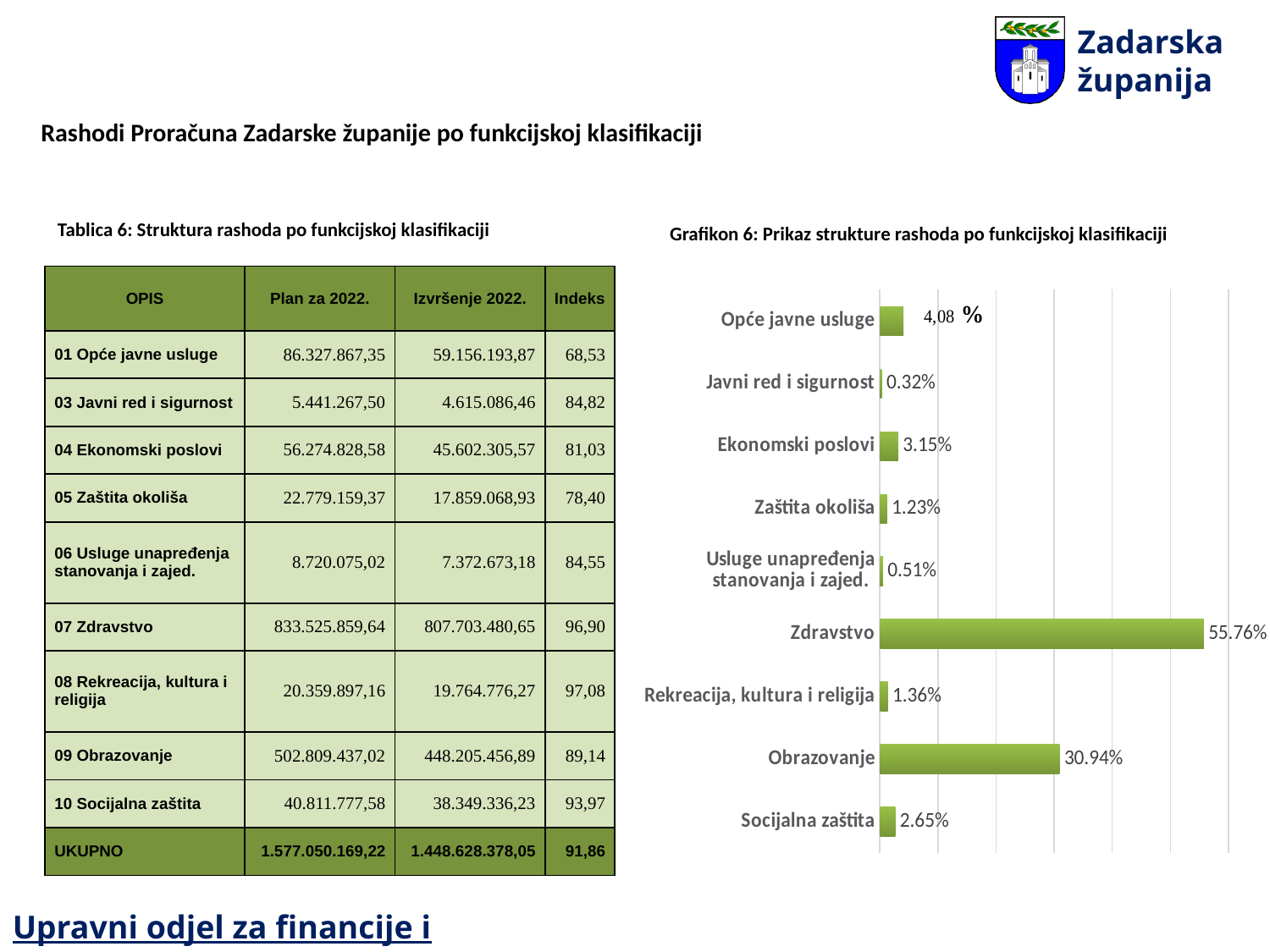
What is the difference between the values for Zdravstvo and Obrazovanje? 24.82% What is the value for Ekonomski poslovi in the chart? 3.15% Which category has the lowest value in the chart? Javni red i sigurnost What is the value for Javni red i sigurnost in the chart? 0.32% Which is larger, the value for Ekonomski poslovi or the value for Socijalna zaštita? Ekonomski poslovi What is the title of the chart? Grafikon 6: Prikaz strukture rashoda po funkcijskoj klasifikaciji What is the value for Obrazovanje in the chart? 30.94% What is the value for Zdravstvo in the chart? 55.76% What is the value for Socijalna zaštita in the chart? 2.65% Which category has the highest value in the chart? Zdravstvo How many categories are shown in the chart? 9 What kind of chart is shown on the slide? bar chart